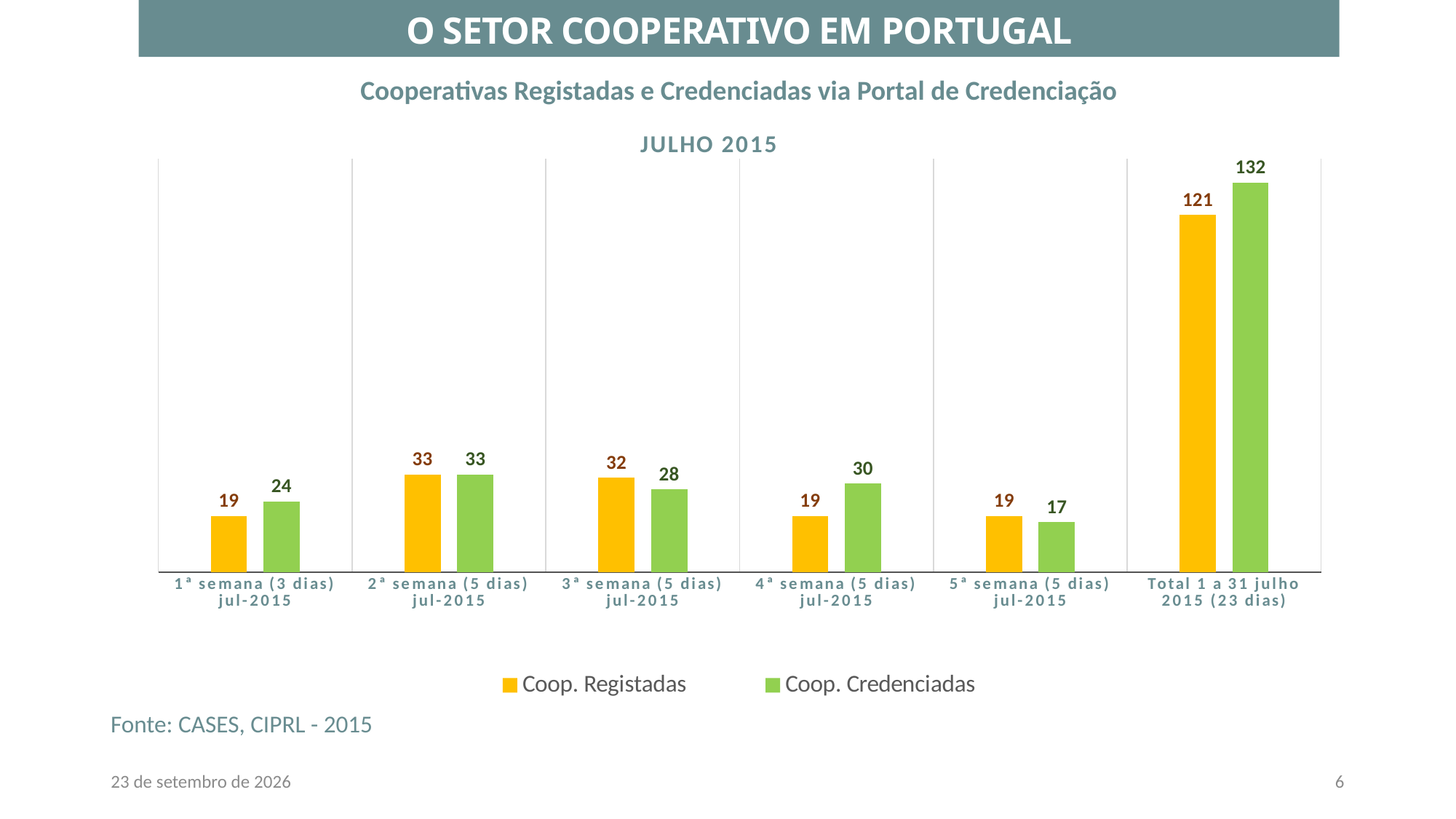
How many categories are shown on the x axis? 6 What kind of chart is shown on the slide? Bar chart What is the difference between Coop. Credenciadas and Coop. Registadas for Total 1 a 31 julho 2015 (23 dias)? 11 What is the value of Coop. Credenciadas for Total 1 a 31 julho 2015 (23 dias)? 132 For 5ª semana (5 dias) jul-2015, which is larger: Coop. Registadas or Coop. Credenciadas? Coop. Registadas Which category has the lowest value for Coop. Credenciadas? 5ª semana (5 dias) jul-2015 For 3ª semana (5 dias) jul-2015, which is larger: Coop. Registadas or Coop. Credenciadas? Coop. Registadas How many series does the legend list? 2 What is the difference between Coop. Credenciadas and Coop. Registadas for 4ª semana (5 dias) jul-2015? 11 What is the value of Coop. Registadas for 2ª semana (5 dias) jul-2015? 33 What is the value of Coop. Credenciadas for 1ª semana (3 dias) jul-2015? 24 Among the weekly categories (excluding the total), which has the highest value for Coop. Registadas? 2ª semana (5 dias) jul-2015